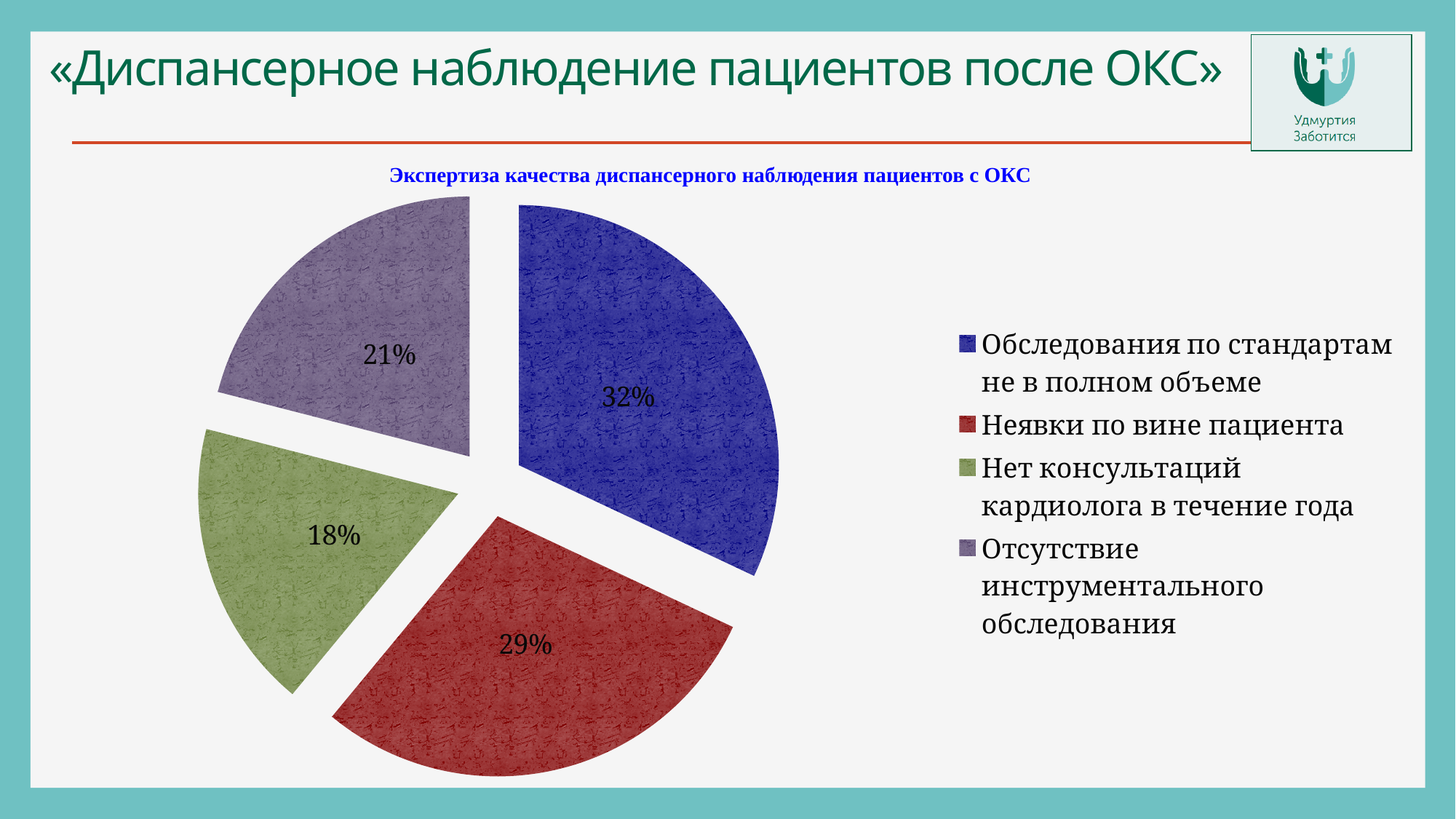
What colour is the slice for "Неявки по вине пациента"? red What type of chart is shown on the slide? pie chart Which is larger: the slice for "Отсутствие инструментального обследования" or the slice for "Нет консультаций кардиолога в течение года"? Отсутствие инструментального обследования What share of the pie is labelled "Нет консультаций кардиолога в течение года"? 18% Which category has the largest slice of the pie? Обследования по стандартам не в полном объеме What share of the pie is labelled "Неявки по вине пациента"? 29% What share of the pie is labelled "Обследования по стандартам не в полном объеме"? 32% Which category has the smallest slice of the pie? Нет консультаций кардиолога в течение года What is the difference in percentage points between "Неявки по вине пациента" and "Нет консультаций кардиолога в течение года"? 11 How many categories does the pie chart have? 4 What share of the pie is labelled "Отсутствие инструментального обследования"? 21% What is the title of the chart? Экспертиза качества диспансерного наблюдения пациентов с ОКС